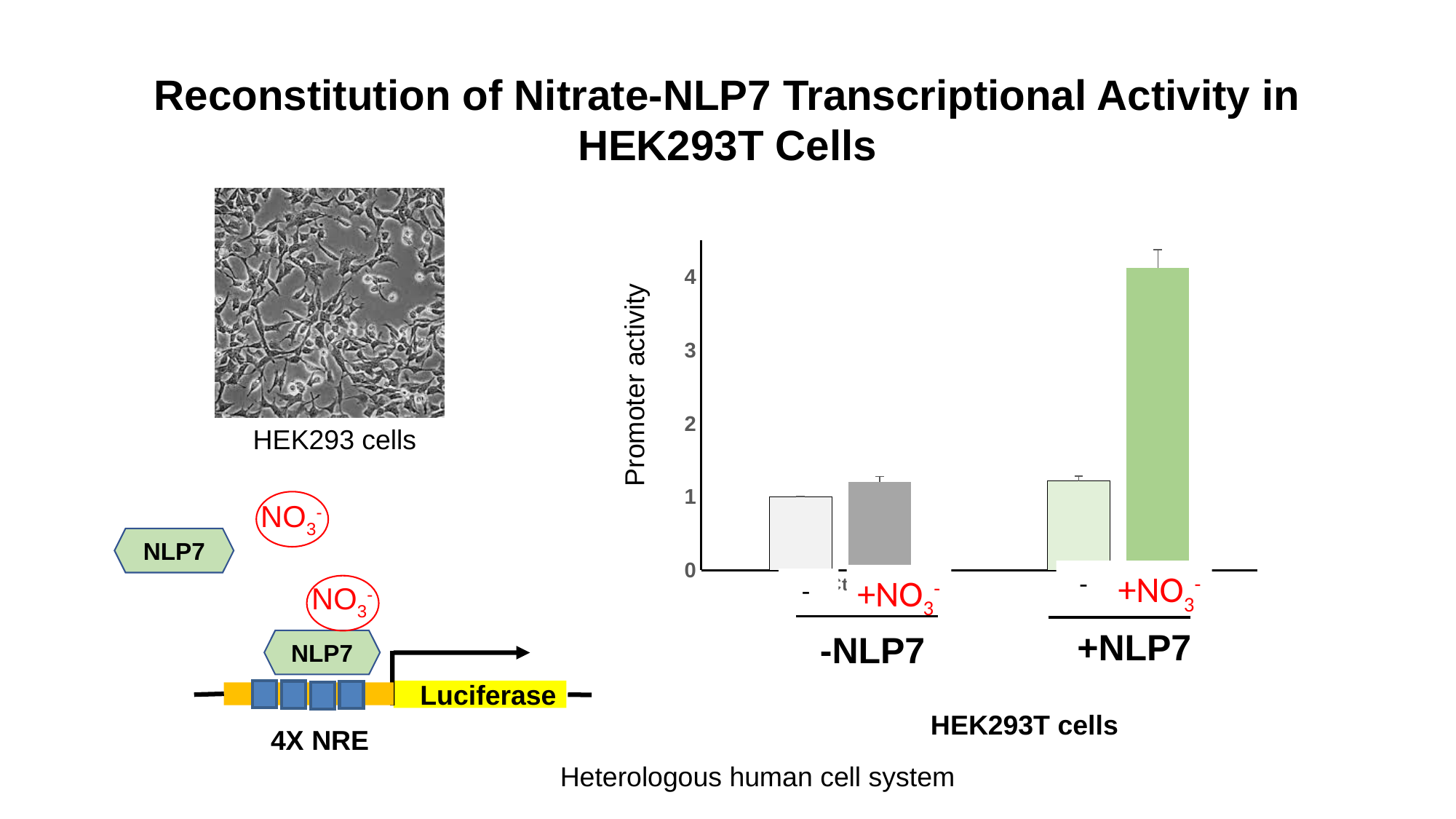
Is the promoter activity for +NLP7 without nitrate (-) greater or less than 2? less Which is larger: promoter activity for +NLP7 with +NO3- or for -NLP7 with +NO3-? +NLP7 with +NO3- Within the +NLP7 group, does promoter activity rise or fall when nitrate is added? rise Is the promoter activity for +NLP7 with +NO3- greater or less than 3? greater Is the promoter activity for -NLP7 with +NO3- greater or less than 2? less What kind of chart is shown on the right of the slide? bar chart What are the two group labels shown under the x axis of the chart? -NLP7 and +NLP7 How many bars are plotted in the promoter activity chart? 4 What is the highest tick value shown on the y axis of the chart? 4 What is the label of the y axis of the chart? Promoter activity Which condition has the highest promoter activity? +NLP7 with +NO3-